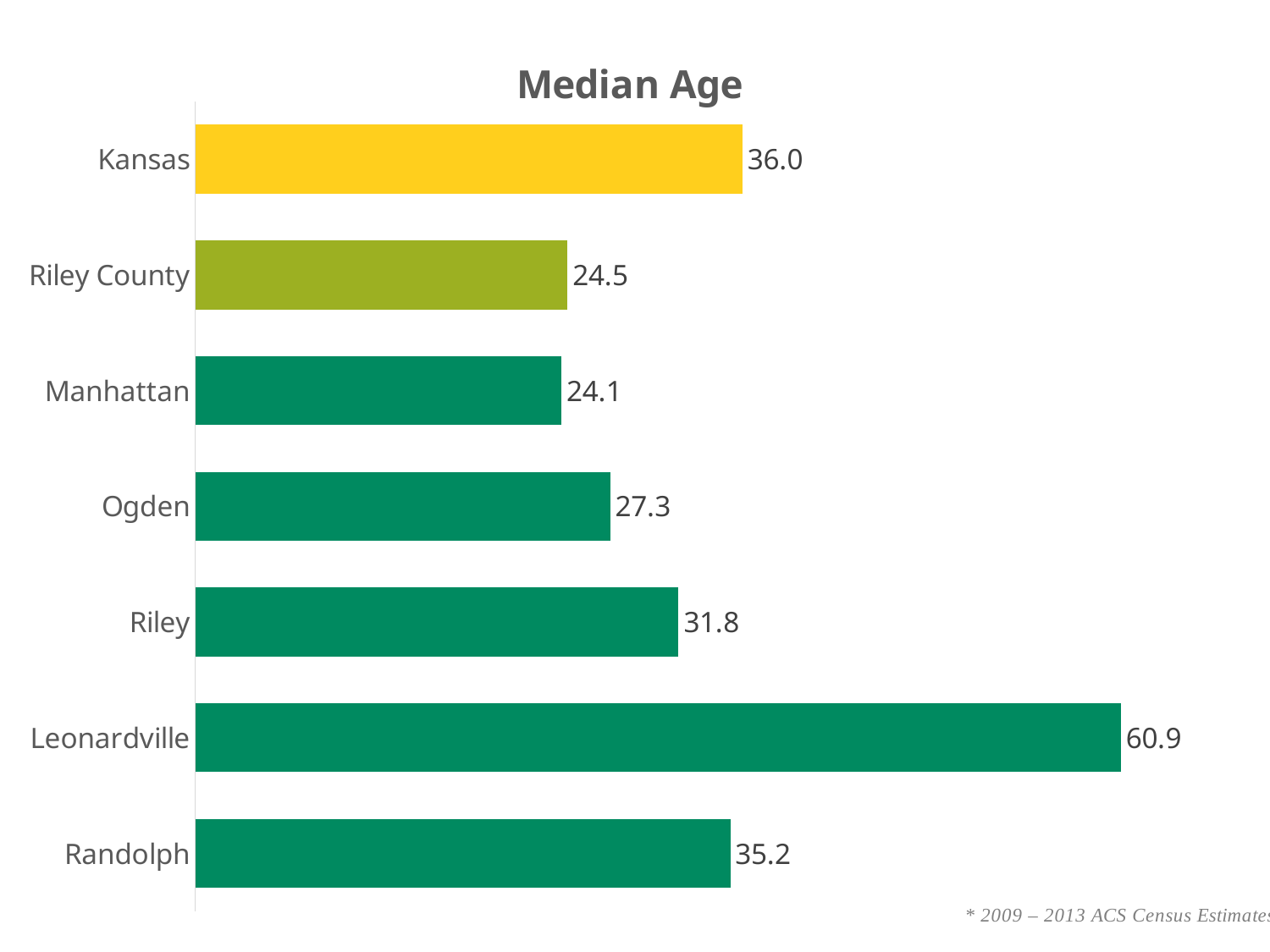
What is the title of the chart? Median Age What is the median age shown for Ogden? 27.3 Which category has the lowest median age? Manhattan What is the median age shown for Leonardville? 60.9 What is the median age shown for Kansas? 36.0 Which has a higher median age, Riley or Ogden? Riley Which category has the highest median age? Leonardville What kind of chart is shown on the slide? Bar chart How many categories are shown in the chart? 7 What is the difference between the median age of Kansas and Riley? 4.2 What is the difference between the median age of Leonardville and Randolph? 25.7 What is the median age shown for Riley County? 24.5